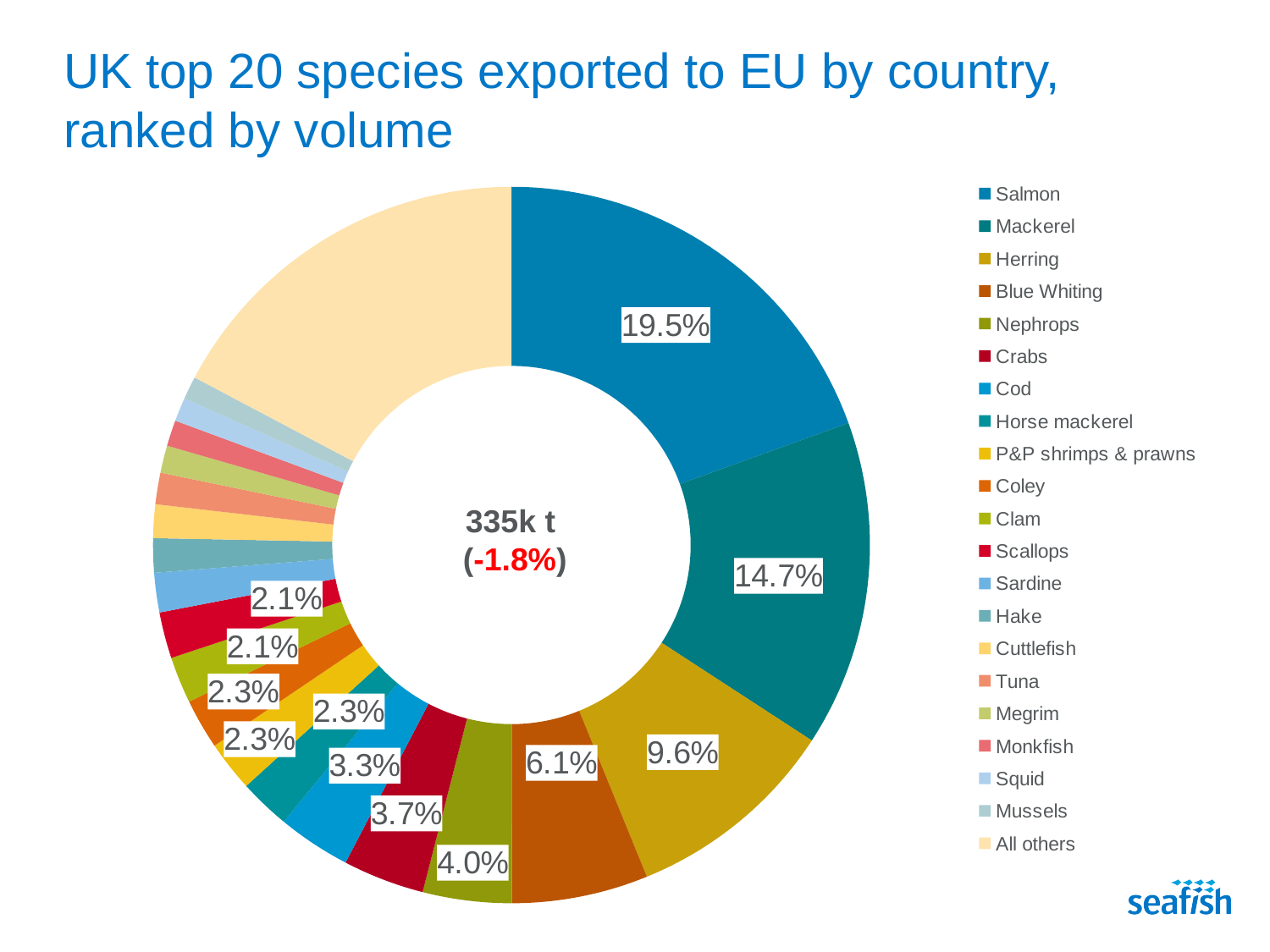
What percentage is shown for Mackerel? 14.7% Which species has the largest share of the chart? Salmon What type of chart is shown on the slide? Pie (doughnut) chart What percentage is shown for Blue Whiting? 6.1% What percentage is shown for Nephrops? 4.0% What share of the chart does Salmon account for? 19.5% What total volume is shown in the centre of the chart? 335k t Which has the larger share, Nephrops or Crabs? Nephrops How many entries does the legend list? 21 What is the difference in percentage points between Salmon and Mackerel? 4.8 percentage points What percentage is shown for Herring? 9.6% What percentage change is shown in red in the centre of the chart? -1.8%